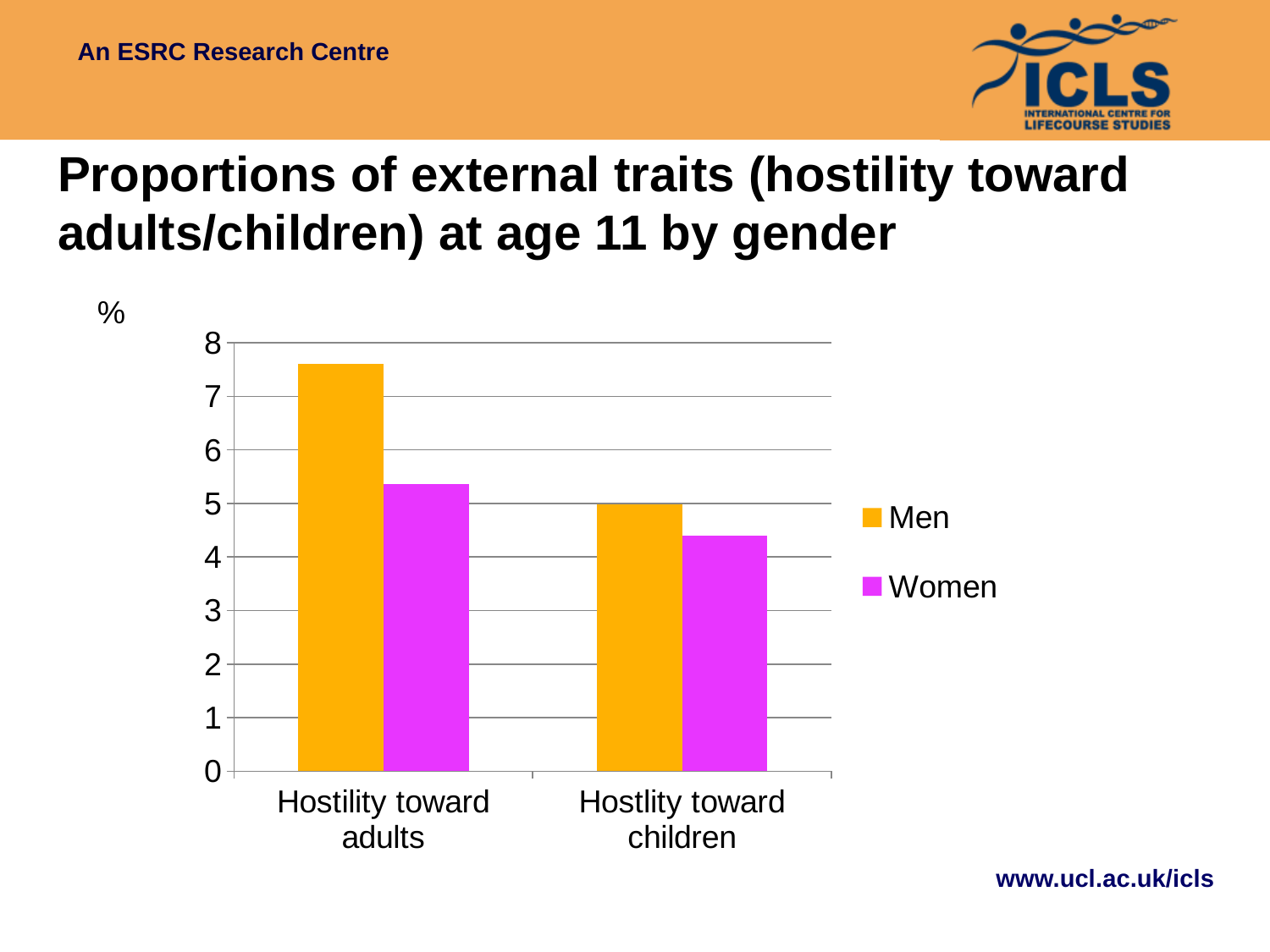
Which bar is the highest in the chart? Men, Hostility toward adults How many categories are shown on the x axis? 2 Which colour represents Women in the chart? magenta Is the value for Women in Hostility toward adults greater or less than 5? greater For Hostlity toward children, which is larger: the value for Men or the value for Women? Men For Hostility toward adults, which is larger: the value for Men or the value for Women? Men Is the value for Women in Hostlity toward children greater or less than 5? less What are the two series named in the legend? Men and Women How many series does the legend list? 2 Is the value for Men in Hostility toward adults greater or less than 7? greater What kind of chart is shown on the slide? bar chart Which bar is the lowest in the chart? Women, Hostlity toward children